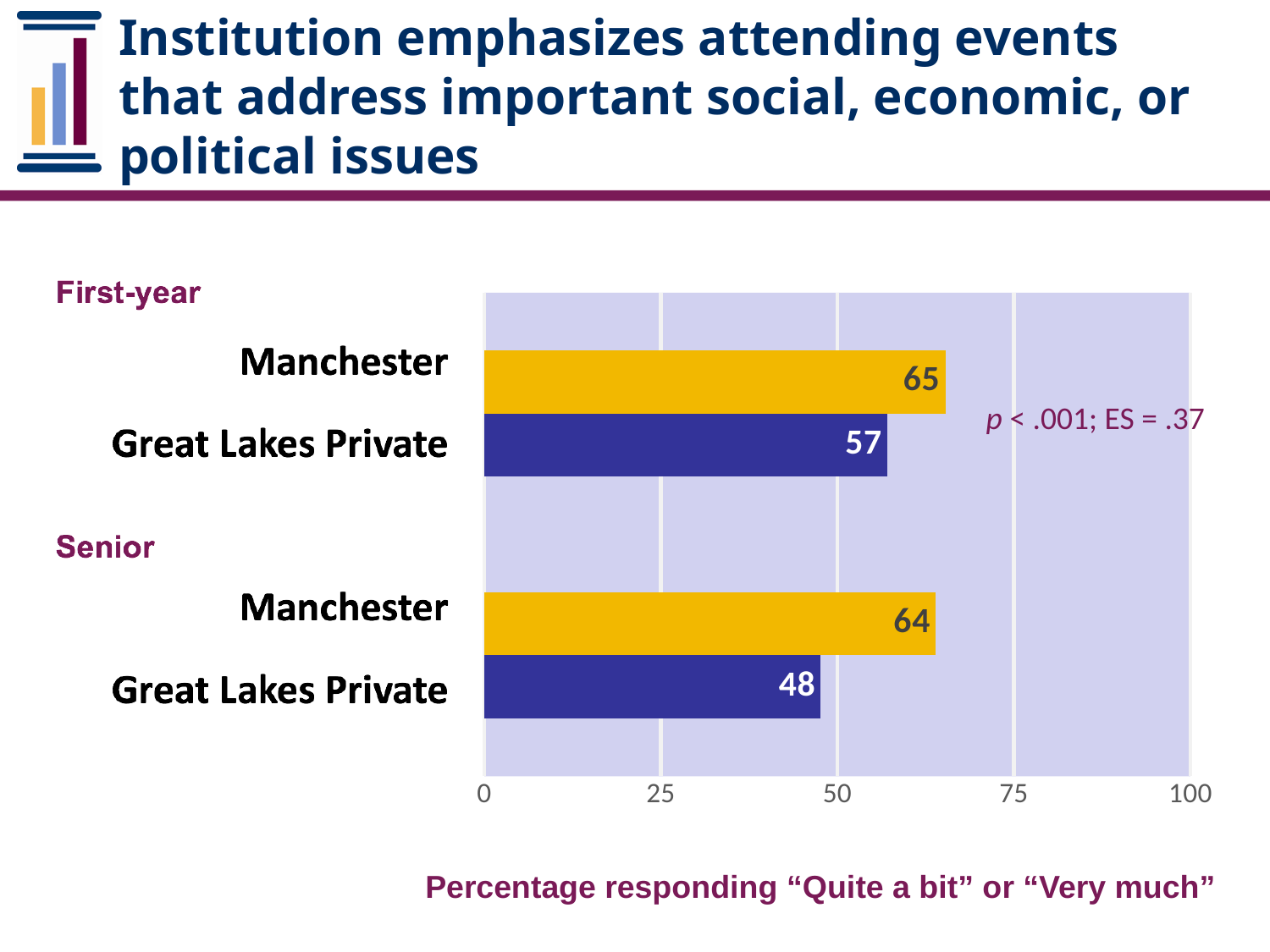
How many bars are plotted in the chart? 4 What is the difference between First-year Manchester and First-year Great Lakes Private? 8 What is the value for Senior Manchester? 64 Which is larger, First-year Great Lakes Private or Senior Great Lakes Private? First-year Great Lakes Private Which bar has the lowest value? Senior Great Lakes Private What is the maximum value shown on the x axis? 100 What is the difference between Senior Manchester and Senior Great Lakes Private? 16 Which bar has the highest value? First-year Manchester What kind of chart is shown on the slide? Bar chart What is the value for Senior Great Lakes Private? 48 What is the value for First-year Great Lakes Private? 57 What is the value for First-year Manchester? 65